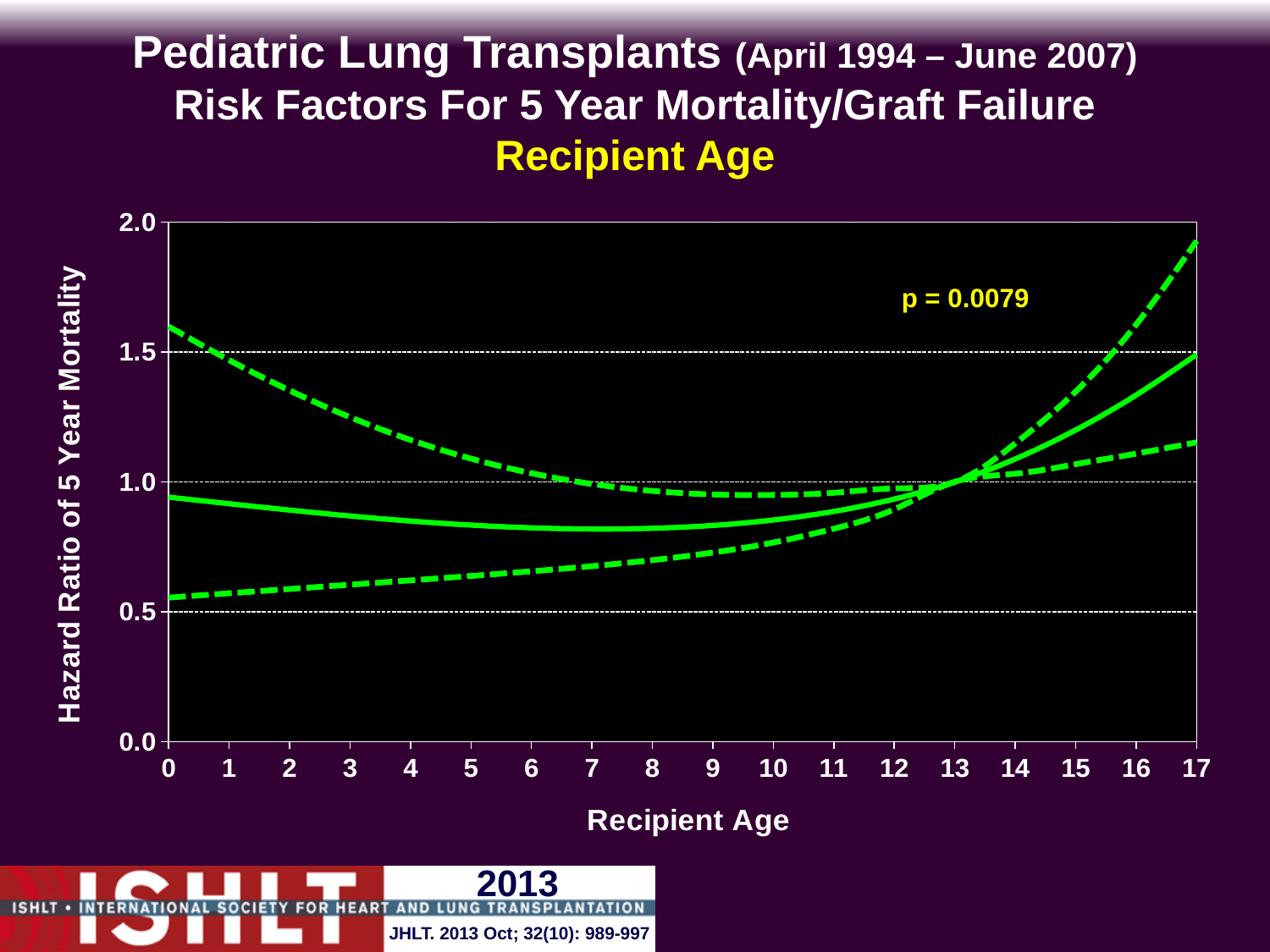
Is the value of the lower dashed line at recipient age 17 greater or less than 1.0? greater Is the value of the solid line at recipient age 7 greater or less than 1.0? less Does the upper dashed line rise or fall between recipient age 0 and recipient age 7? fall How many lines are plotted on the chart? 3 What p-value is printed on the chart? p = 0.0079 How many tick labels are shown on the Recipient Age axis? 18 Is the value of the upper dashed line at recipient age 17 greater or less than 1.5? greater What kind of chart is shown on the slide? line chart Does the solid line rise or fall between recipient age 13 and recipient age 17? rise What is the label of the vertical axis? Hazard Ratio of 5 Year Mortality